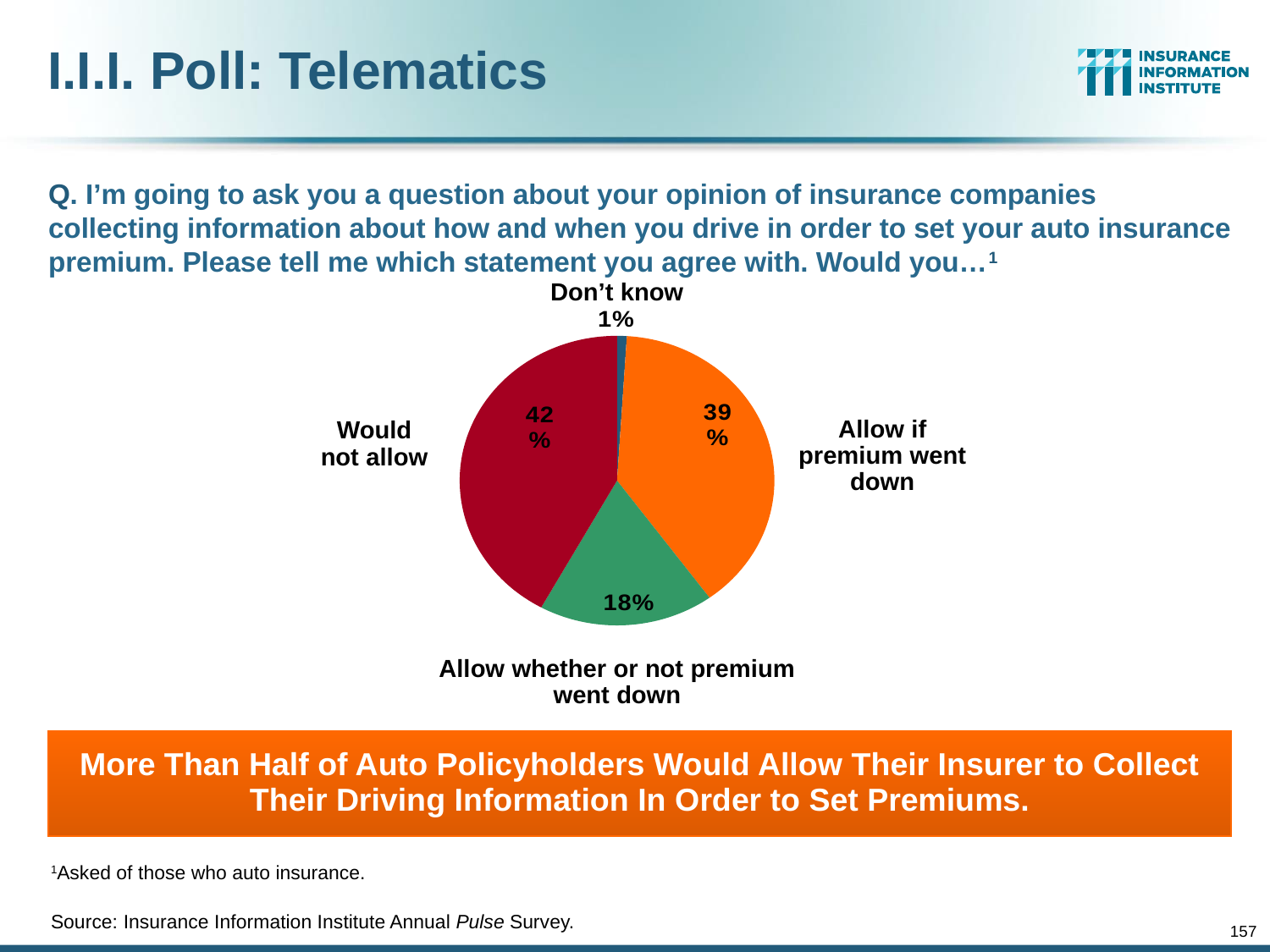
Which response has the smallest share of the pie? Don't know How many slices does the pie chart have? 4 What is the difference in percentage points between 'Would not allow' and 'Allow if premium went down'? 3 What percentage of respondents would allow it whether or not their premium went down? 18% What colour is the 'Would not allow' slice? red What is the combined percentage of respondents who would allow it either if the premium went down or whether or not it went down? 57% Which is larger: 'Allow if premium went down' or 'Allow whether or not premium went down'? Allow if premium went down What kind of chart is shown on the slide? pie chart What percentage of respondents answered 'Don't know'? 1% Which response has the largest share of the pie? Would not allow What percentage of respondents would allow it if their premium went down? 39% What percentage of respondents said they would not allow insurers to collect driving information? 42%